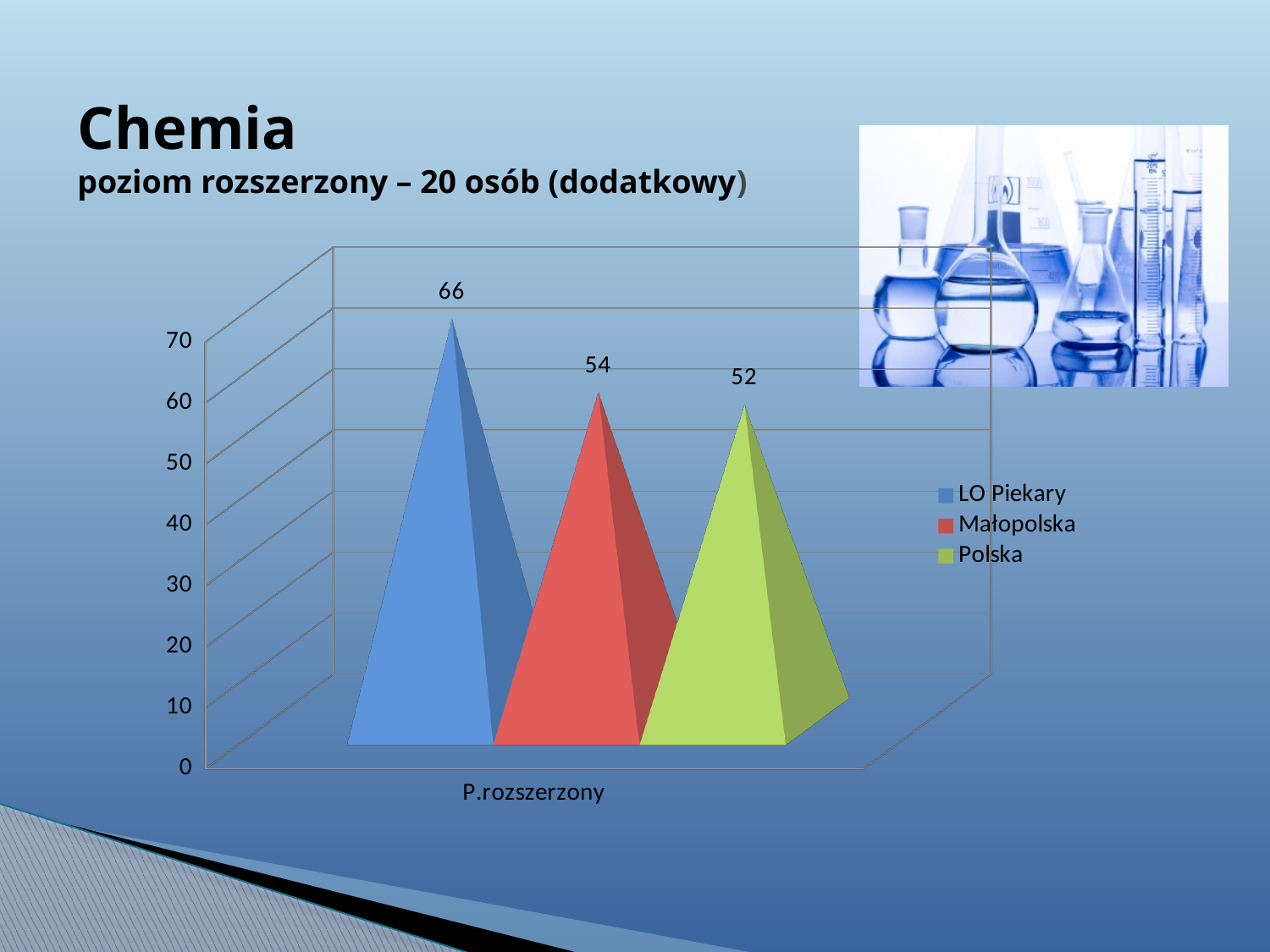
What is the difference between the LO Piekary value and the Małopolska value? 12 What is the label of the category on the x axis? P.rozszerzony Which is larger, the value for LO Piekary or the value for Polska? LO Piekary Which series has the highest value? LO Piekary What is the value for Polska in the P.rozszerzony category? 52 What colour represents Małopolska in the chart? Red Which series has the lowest value? Polska What is the difference between the Małopolska value and the Polska value? 2 What is the value for LO Piekary in the P.rozszerzony category? 66 How many series does the legend list? 3 What is the value for Małopolska in the P.rozszerzony category? 54 How many categories are shown on the x axis? 1